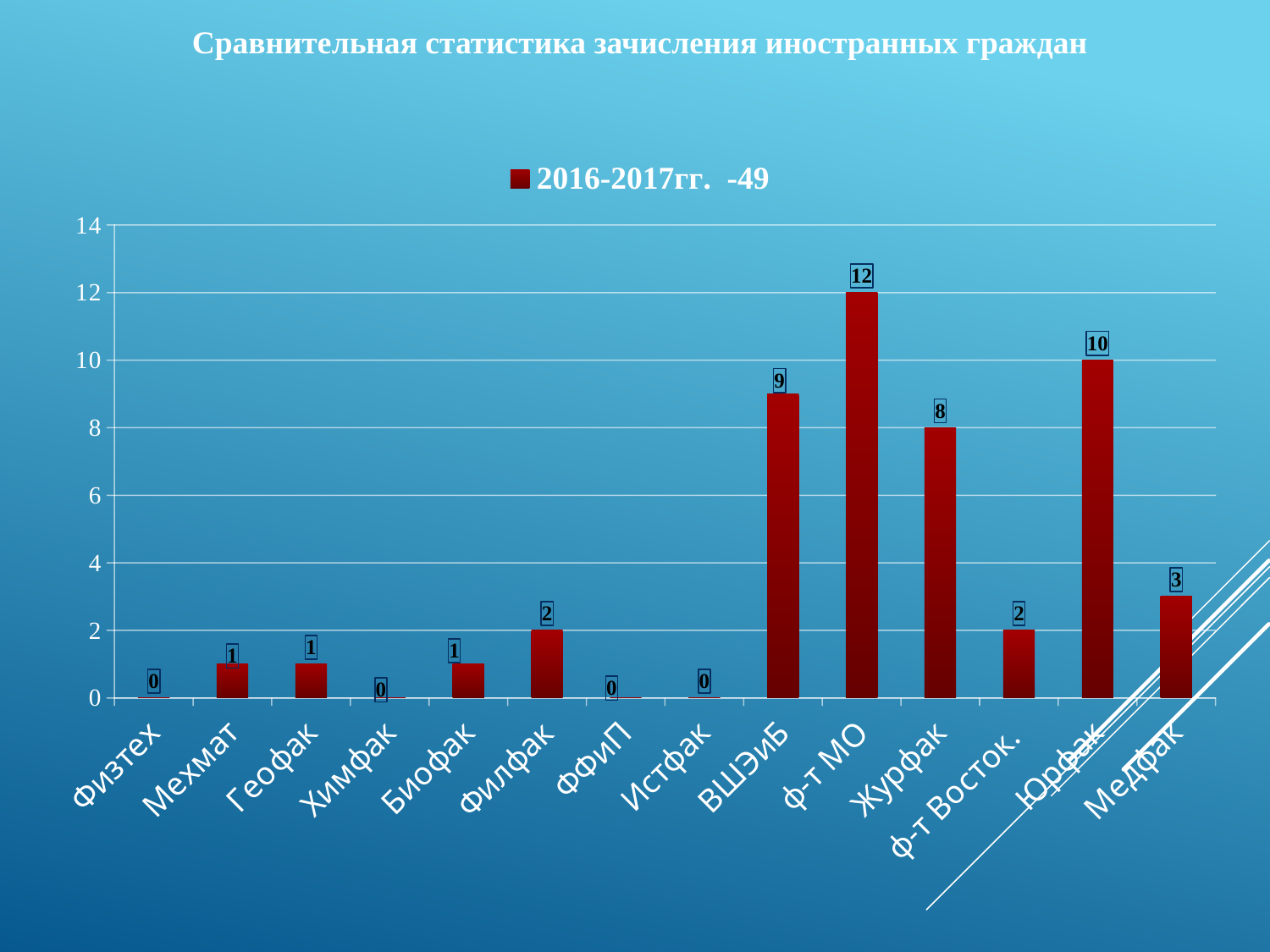
What is the value for Медфак? 3 What is the value for Филфак? 2 What kind of chart is shown on the slide? Bar chart How many categories are shown on the x axis? 14 What is the difference between the values for ф-т МО and Юрфак? 2 What is the value for Журфак? 8 What is the difference between the values for ВШЭиБ and Медфак? 6 What is the value for ф-т МО? 12 Which category has the highest value? ф-т МО How many series does the legend list? 1 Which is larger, the value for ВШЭиБ or the value for Журфак? ВШЭиБ What is the legend entry of the series shown? 2016-2017гг. -49